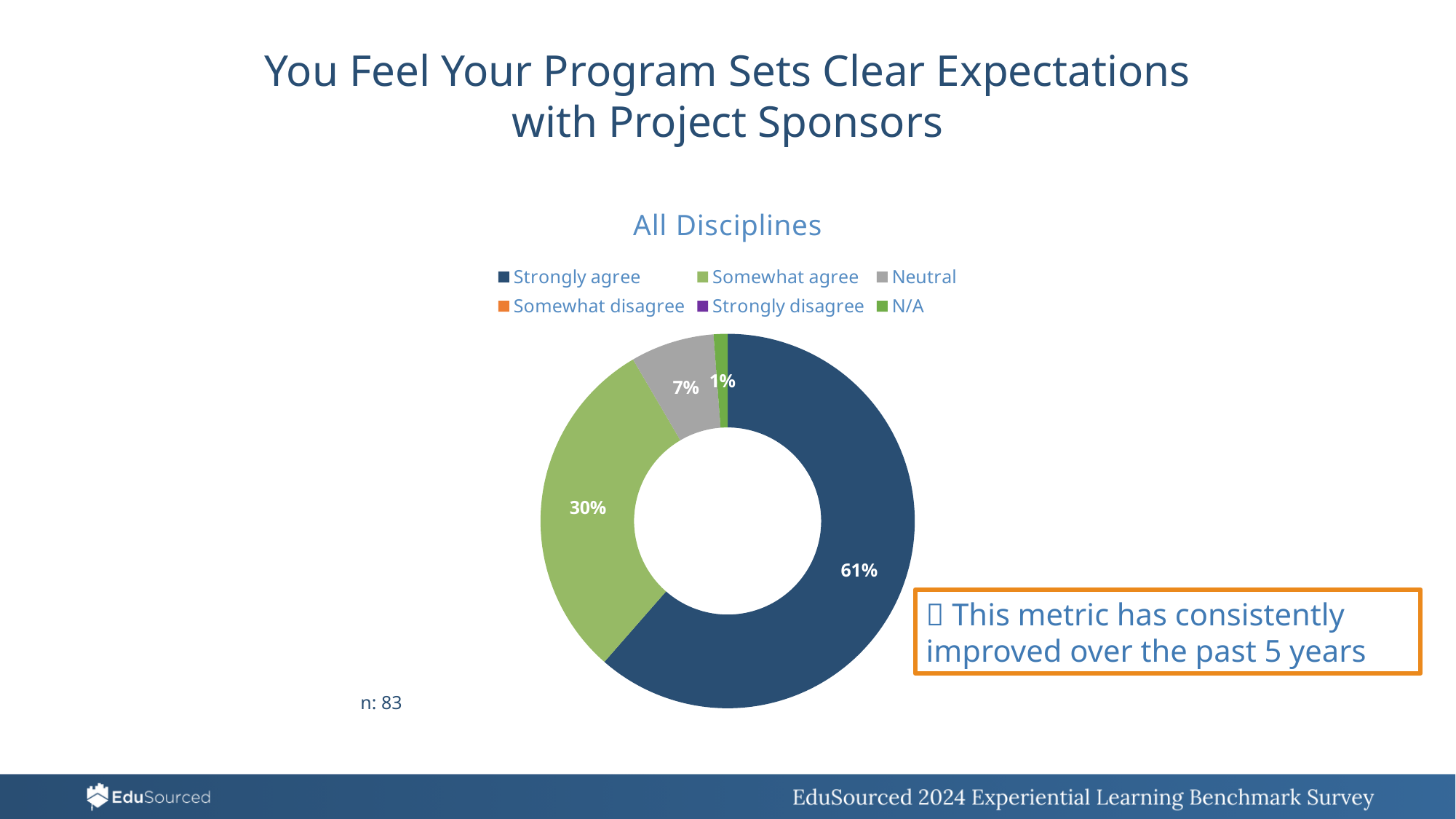
What share of respondents answered N/A? 1% What is the difference in percentage points between Strongly agree and Somewhat agree? 31 What is the combined share of Strongly agree and Somewhat agree? 91% What share of respondents answered Strongly agree? 61% What share of respondents answered Neutral? 7% What kind of chart is shown on the slide? Pie chart (donut) Which is larger, the share for Somewhat agree or the share for Neutral? Somewhat agree Which response category has the largest share of the pie? Strongly agree What is the chart's title? All Disciplines How many entries does the legend list? 6 What share of respondents answered Somewhat agree? 30% What is the sample size (n) shown on the slide? 83